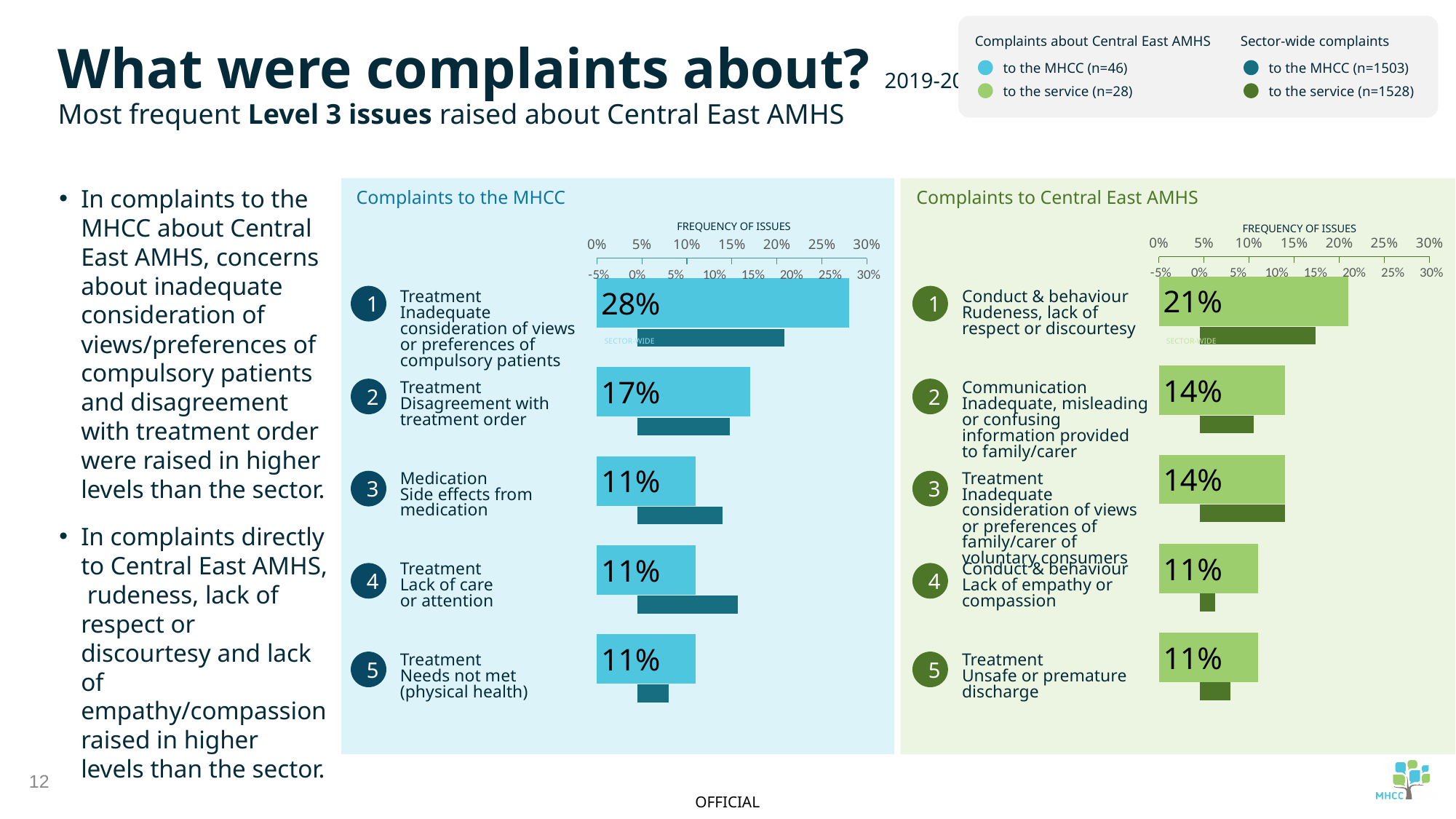
Which is larger: the frequency of 'Treatment – Disagreement with treatment order' in the 'Complaints to the MHCC' chart or 'Communication – Inadequate, misleading or confusing information provided to family/carer' in the 'Complaints to Central East AMHS' chart? Treatment – Disagreement with treatment order (17%) In the 'Complaints to the MHCC' chart, is the sector-wide value for 'Treatment – Needs not met (physical health)' greater or less than 5%? less In the 'Complaints to Central East AMHS' chart, what is the difference between the frequency of 'Conduct & behaviour – Rudeness, lack of respect or discourtesy' and 'Communication – Inadequate, misleading or confusing information provided to family/carer'? 7% In the 'Complaints to Central East AMHS' chart, what is the frequency for 'Treatment – Unsafe or premature discharge'? 11% In the 'Complaints to Central East AMHS' chart, what is the frequency for 'Conduct & behaviour – Rudeness, lack of respect or discourtesy'? 21% What type of chart is used in the 'Complaints to the MHCC' panel? Bar chart In the 'Complaints to Central East AMHS' chart, which issue has the highest frequency? Conduct & behaviour – Rudeness, lack of respect or discourtesy In the 'Complaints to the MHCC' chart, what is the frequency for 'Treatment – Disagreement with treatment order'? 17% How many issues are listed in the 'Complaints to Central East AMHS' chart? 5 In the 'Complaints to the MHCC' chart, which issue has the highest frequency? Treatment – Inadequate consideration of views or preferences of compulsory patients In the 'Complaints to the MHCC' chart, what is the difference between the frequencies of the top two issues (28% and 17%)? 11% In the 'Complaints to the MHCC' chart, what is the frequency for 'Treatment – Inadequate consideration of views or preferences of compulsory patients'? 28%